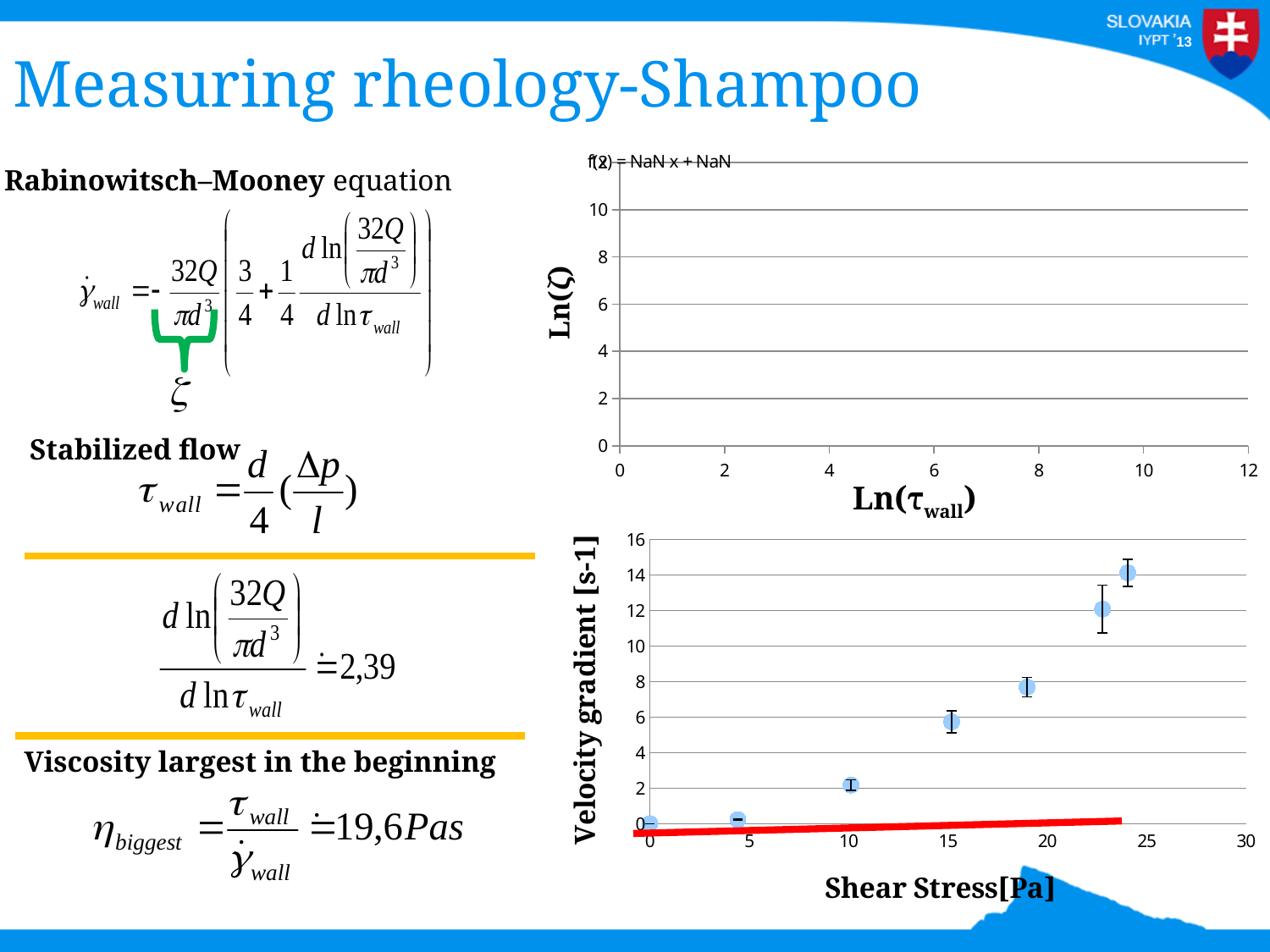
How many data points are visible in the top chart (Ln(ζ) vs Ln(τwall))? 0 In the bottom chart, is the velocity gradient of the point nearest shear stress 15 Pa greater or less than 4? greater What is the x-axis label of the bottom chart? Shear Stress[Pa] What is the y-axis label of the top chart? Ln(ζ) In the bottom chart, is the velocity gradient of the point nearest shear stress 10 Pa greater or less than 4? less In the bottom chart, does the velocity gradient rise or fall as shear stress increases? rise What kind of chart is the bottom chart (Velocity gradient vs Shear Stress)? scatter chart In the bottom chart, which has the larger velocity gradient: the point nearest shear stress 19 Pa or the point nearest shear stress 23 Pa? the point nearest 23 Pa In the bottom chart, does the point with the highest velocity gradient also have the highest shear stress? yes How many data points are plotted in the bottom chart (Velocity gradient vs Shear Stress)? 7 In the bottom chart, is the velocity gradient of the point nearest shear stress 15 Pa greater or less than 8? less